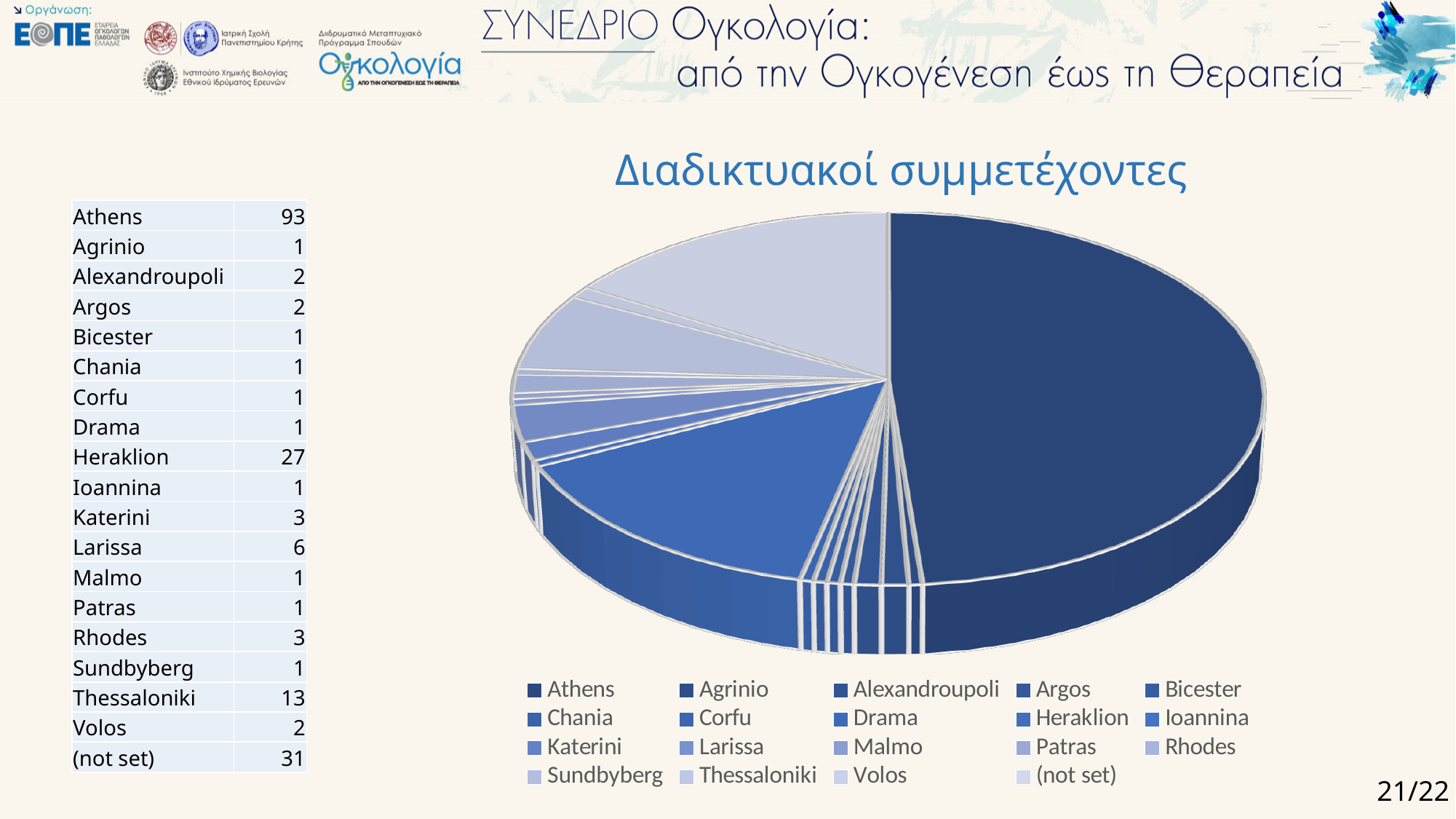
What is the value for Thessaloniki? 13 Which category has the largest slice of the pie? Athens Which is larger, the value for Larissa or the value for Katerini? Larissa What kind of chart is shown on the slide? Pie chart What is the title of the chart? Διαδικτυακοί συμμετέχοντες What is the difference between the values for Athens and Heraklion? 66 What is the difference between the values for (not set) and Thessaloniki? 18 What is the value for Heraklion? 27 What is the value for Athens? 93 How many categories does the pie chart have? 19 Which is larger, the value for Heraklion or the value for (not set)? (not set) What is the value for (not set)? 31